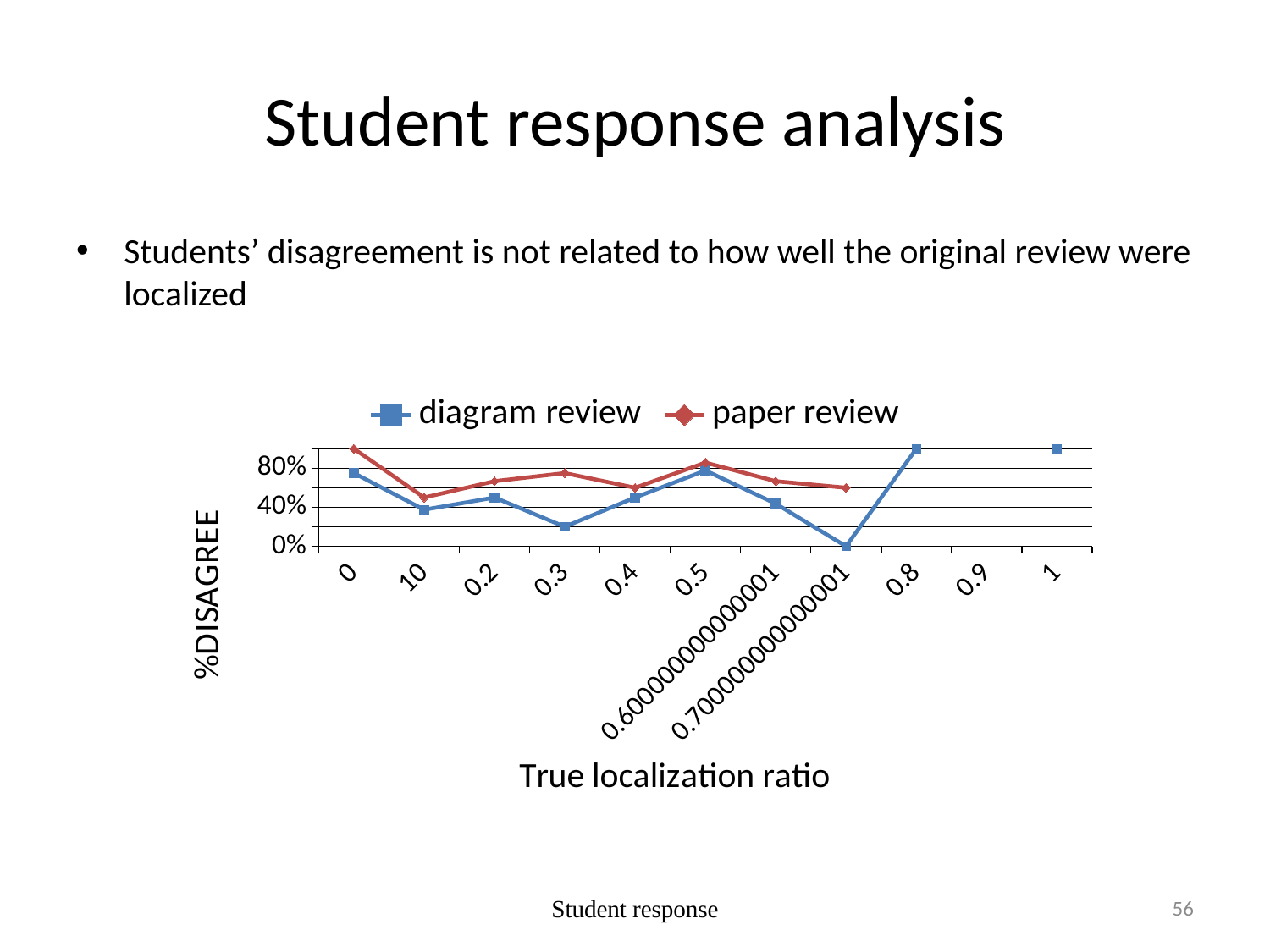
At which true localization ratio does the diagram review series reach its lowest value? 0.7000000000000001 Is the diagram review value at a true localization ratio of 0.3 greater or less than 40%? less Is the paper review value at a true localization ratio of 0.2 greater or less than 40%? greater What are the two series named in the chart legend? diagram review and paper review What kind of chart is shown on the slide? line chart Is the diagram review value at a true localization ratio of 0.8 greater or less than 80%? greater What is the title of the x axis of the chart? True localization ratio How many series does the chart legend list? 2 What is the diagram review value at a true localization ratio of 0.7000000000000001? 0% How many categories are shown along the x axis of the chart? 11 At a true localization ratio of 0.3, which series has the larger value, diagram review or paper review? paper review